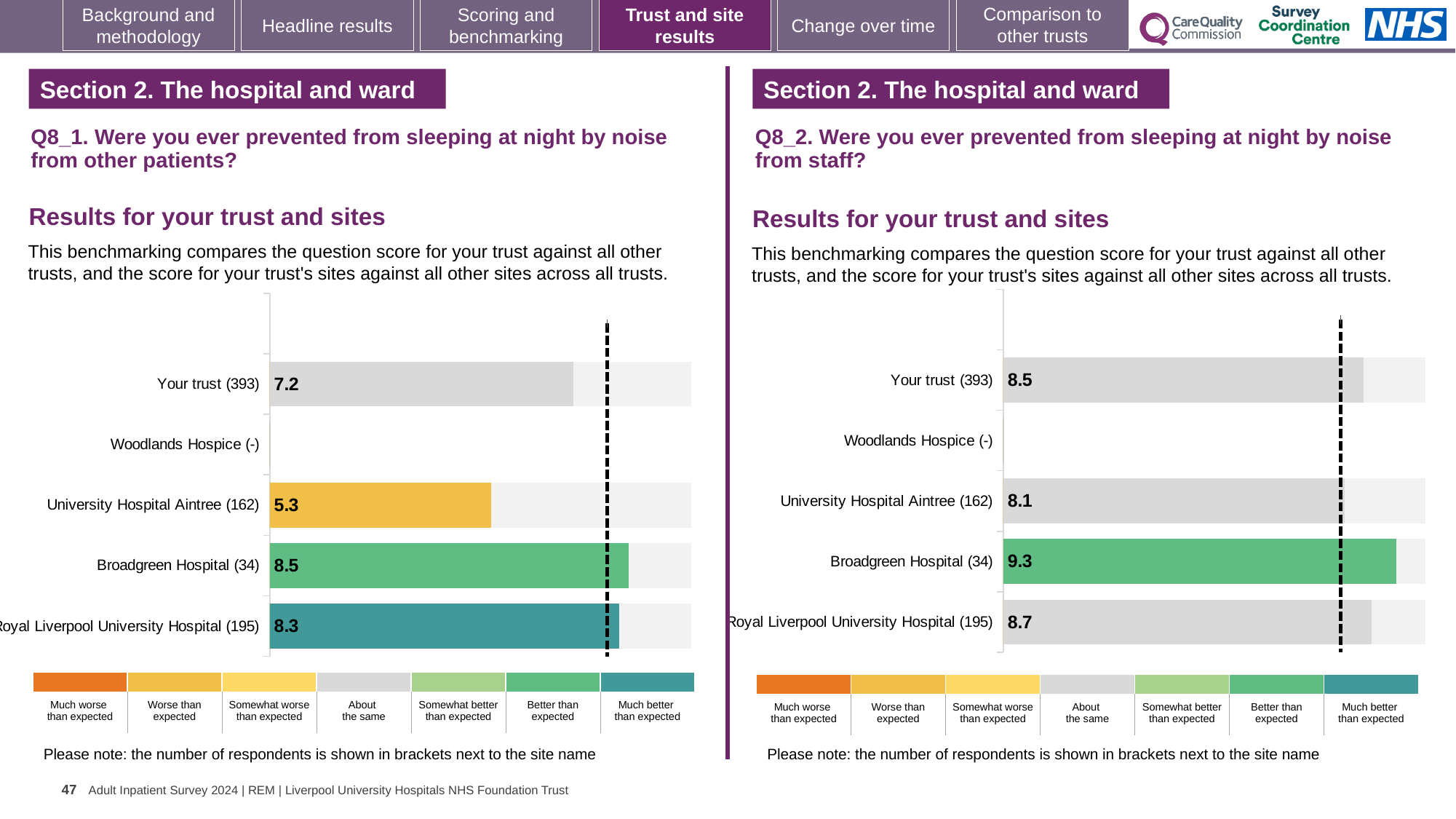
How many sites/categories are listed on the vertical axis of the Q8_1 chart (noise from other patients)? 5 In the Q8_2 chart (noise from staff), which site has the highest score? Broadgreen Hospital In the Q8_1 chart (noise from other patients), what is the score for Your trust? 7.2 In the Q8_2 chart (noise from staff), what is the score for Broadgreen Hospital? 9.3 In the Q8_2 chart (noise from staff), what is the score for Royal Liverpool University Hospital? 8.7 In the Q8_2 chart (noise from staff), what is the difference between the scores for Broadgreen Hospital and Your trust? 0.8 In the Q8_1 chart (noise from other patients), which benchmark category does the colour of the Royal Liverpool University Hospital bar correspond to? Much better than expected In the Q8_1 chart (noise from other patients), what is the difference between the scores for Broadgreen Hospital and University Hospital Aintree? 3.2 In the Q8_2 chart (noise from staff), which has the higher score: University Hospital Aintree or Royal Liverpool University Hospital? Royal Liverpool University Hospital In the Q8_1 chart (noise from other patients), what is the score for University Hospital Aintree? 5.3 What type of chart is used for the Q8_2 results (noise from staff)? Bar chart In the Q8_1 chart (noise from other patients), which site has the lowest score? University Hospital Aintree